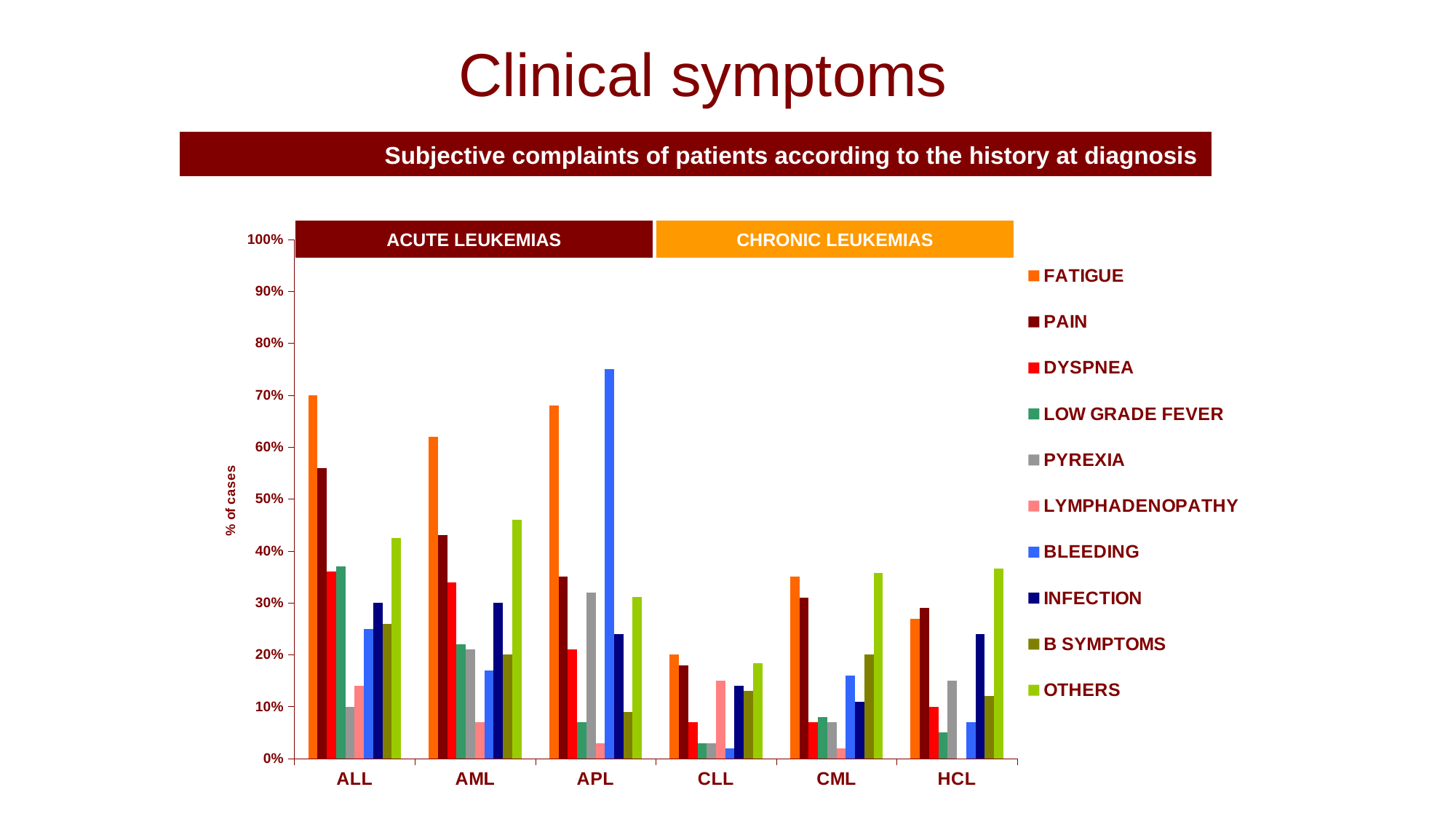
Is the value for BLEEDING in APL greater or less than 70%? greater Is the value for OTHERS in HCL greater or less than 30%? greater How many leukemia categories are shown on the x axis? 6 How many series does the legend list? 10 Is the value for PAIN in ALL greater or less than 50%? greater Which leukemia category has the highest value for BLEEDING? APL Which is larger, the FATIGUE value for ALL or the FATIGUE value for AML? ALL Which leukemia category has the lowest value for FATIGUE? CLL What kind of chart is shown on the slide? bar chart Which is larger, the LYMPHADENOPATHY value for CLL or the LYMPHADENOPATHY value for AML? CLL Which leukemia categories are grouped under the CHRONIC LEUKEMIAS header? CLL, CML, HCL Within the HCL category, which symptom has the highest value? OTHERS